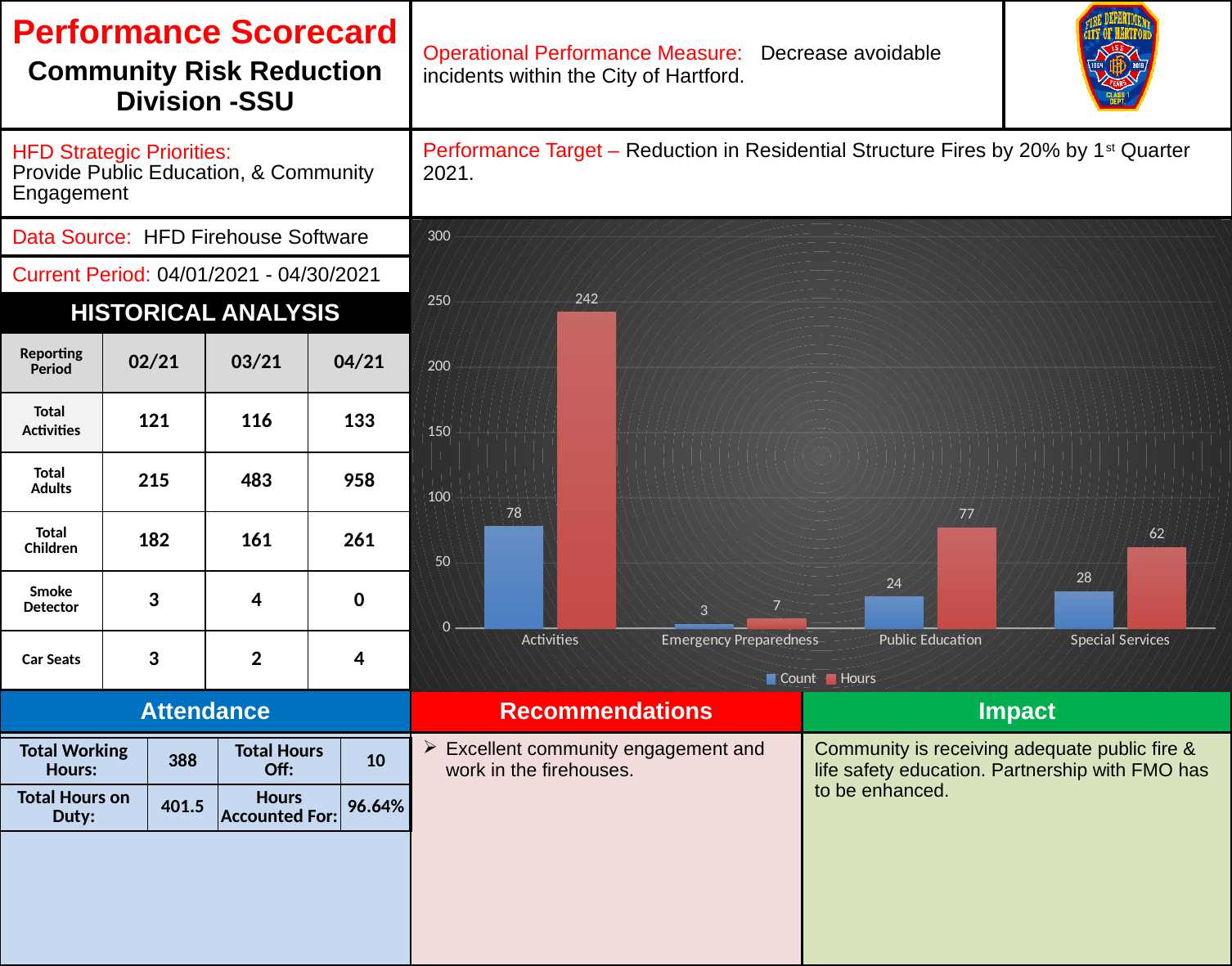
Which category has the highest Hours value? Activities What is the Count value for Special Services? 28 Is the Hours value for Activities greater or less than 200? greater What is the Hours value for Public Education? 77 What kind of chart is shown on the slide? bar chart Which category has the lowest Count value? Emergency Preparedness How many categories are shown on the x axis of the chart? 4 What is the Count value for Activities? 78 What is the Hours value for Activities? 242 What is the difference between the Hours and Count values for Activities? 164 Which is larger, the Hours value for Public Education or the Hours value for Special Services? Public Education How many series does the chart legend list? 2